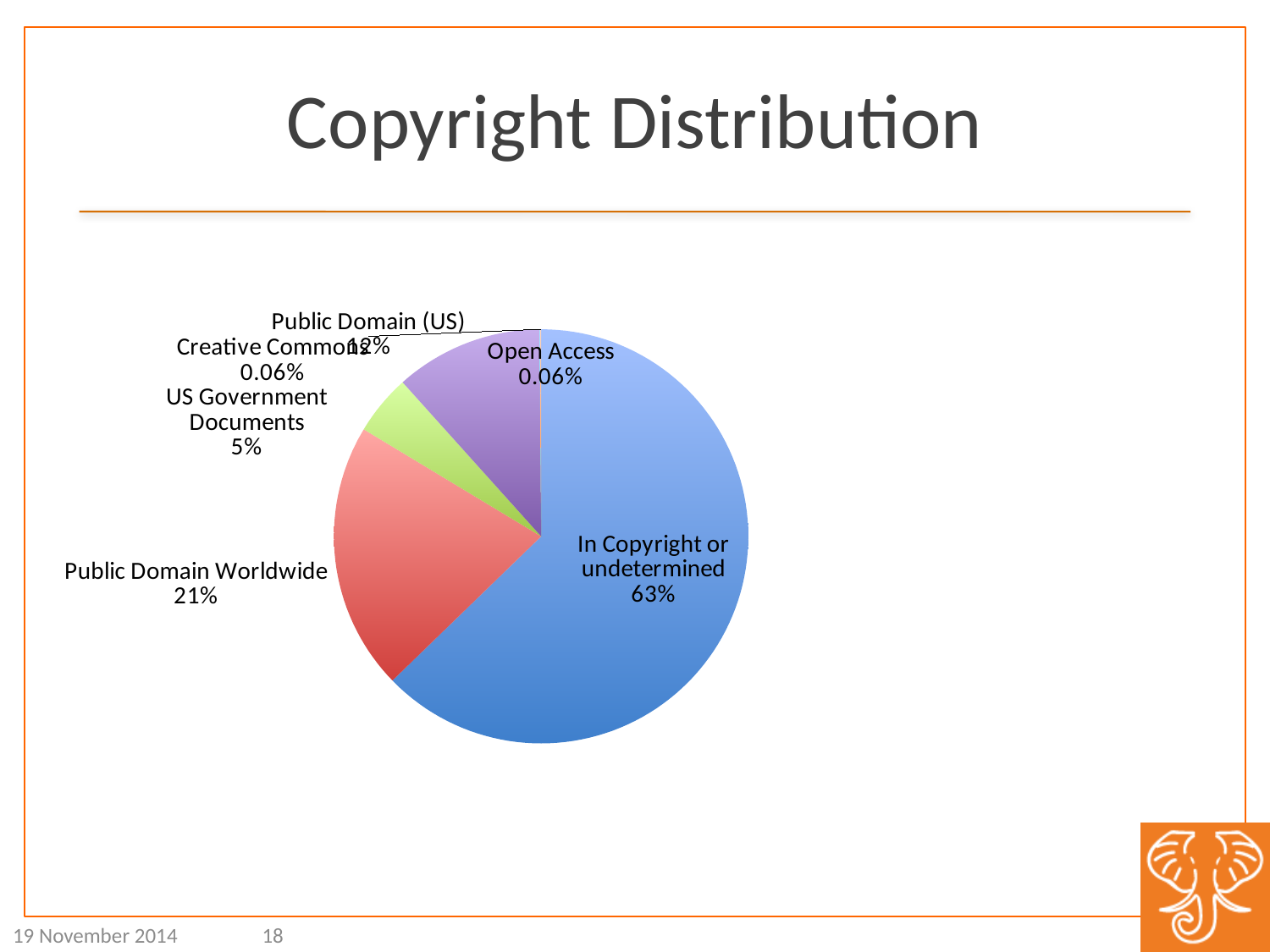
Which category has the largest slice of the pie? In Copyright or undetermined How many percentage points larger is Public Domain Worldwide than US Government Documents? 16 percentage points What share of the pie is In Copyright or undetermined? 63% How many percentage points larger is In Copyright or undetermined than Public Domain Worldwide? 42 percentage points Which is larger: Public Domain Worldwide or US Government Documents? Public Domain Worldwide What share of the pie is Creative Commons? 0.06% What share of the pie is US Government Documents? 5% What share of the pie is Open Access? 0.06% What is the title of the chart? Copyright Distribution What share of the pie is Public Domain Worldwide? 21% What kind of chart is shown on the slide? pie chart How many slices does the pie chart have? 6